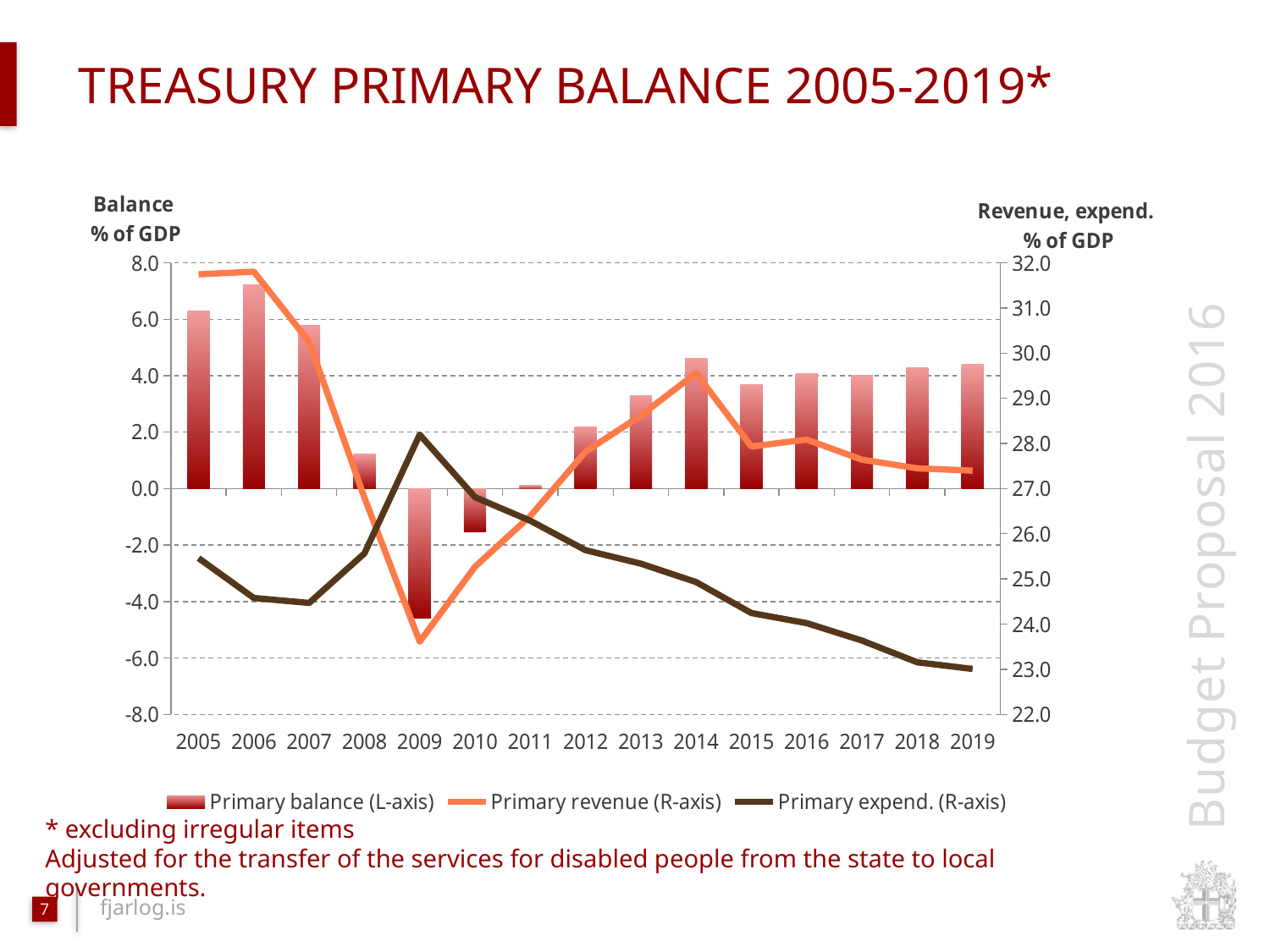
Is the primary balance for 2005 greater or less than 6.0? greater How many years are shown on the x axis? 15 In which year is the primary balance bar lowest? 2009 Is the primary expenditure for 2019 greater or less than 24.0? less Which year has the larger primary balance, 2006 or 2007? 2006 In which year is the primary balance bar highest? 2006 What kind of chart is shown on the slide? A combination bar and line chart Does the primary expenditure line rise or fall from 2009 to 2019? fall Is the primary revenue for 2009 greater or less than 24.0? less How many series does the legend list? 3